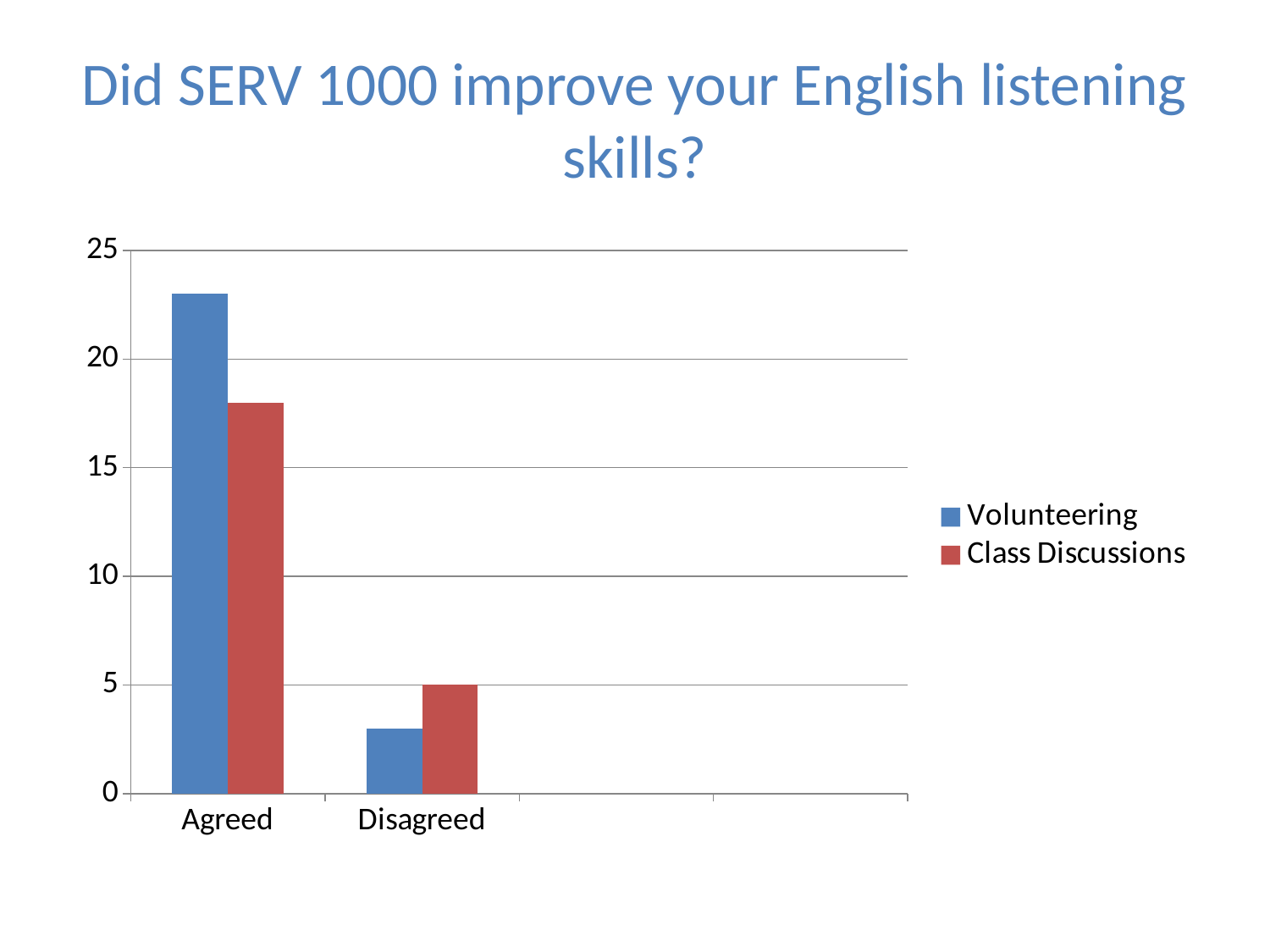
What is the title of the chart? Did SERV 1000 improve your English listening skills? For Disagreed, which series has the larger value, Volunteering or Class Discussions? Class Discussions Which series is shown in blue? Volunteering Is the Class Discussions value for Disagreed greater or less than 10? less Which category has the highest Volunteering value? Agreed How many categories are shown on the x axis? 2 Is the Volunteering value for Disagreed greater or less than 5? less For Agreed, which series has the larger value, Volunteering or Class Discussions? Volunteering How many series does the legend list? 2 What kind of chart is shown on the slide? bar chart Is the Class Discussions value for Agreed greater or less than 20? less